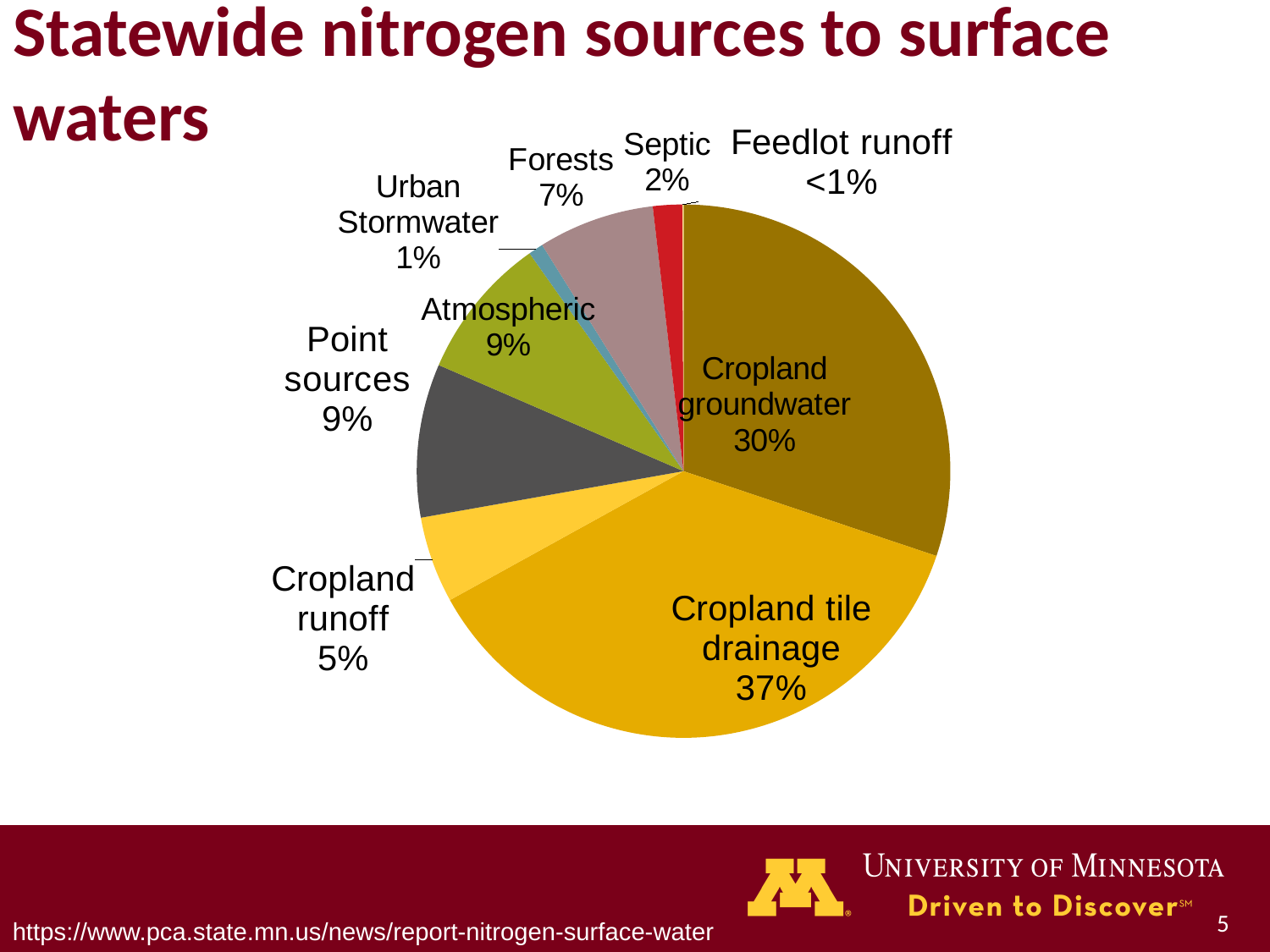
What kind of chart is shown on the slide? Pie chart Which nitrogen source has the largest slice of the pie? Cropland tile drainage What percentage of the pie is Cropland groundwater? 30% What share of statewide nitrogen sources to surface waters comes from Cropland tile drainage? 37% Which is larger, Forests or Septic? Forests Which nitrogen source has the smallest slice of the pie? Feedlot runoff What is the title of the slide containing the chart? Statewide nitrogen sources to surface waters What is the value shown for Atmospheric? 9% How many nitrogen source categories are shown in the pie chart? 9 Which is larger, Cropland runoff or Urban Stormwater? Cropland runoff How many percentage points larger is Cropland tile drainage than Cropland groundwater? 7 percentage points What percentage is shown for Feedlot runoff? <1%